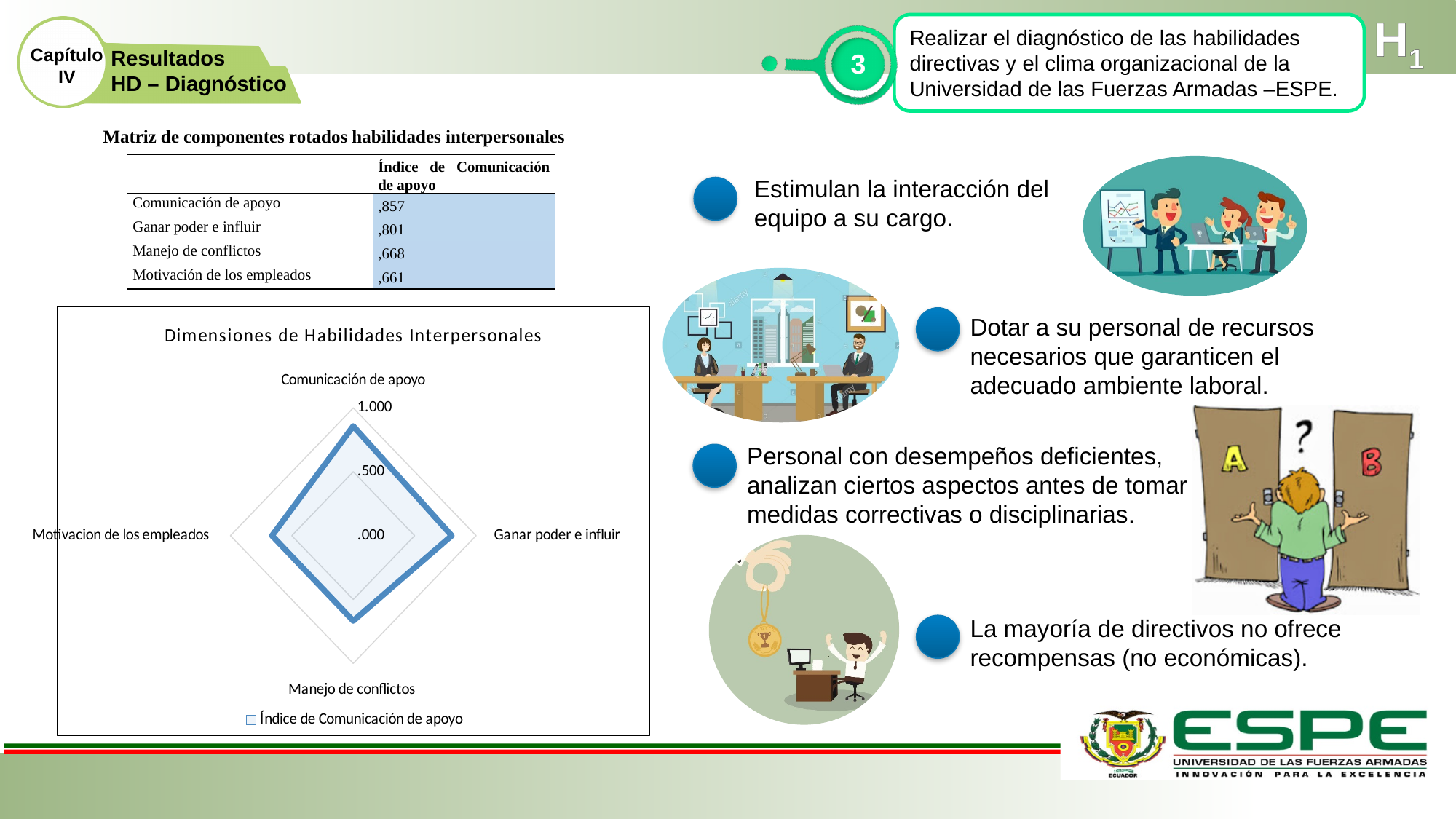
In the radar chart, is the value for Motivacion de los empleados greater or less than .500? greater In the radar chart, which has the larger value: Comunicación de apoyo or Manejo de conflictos? Comunicación de apoyo What is the name of the series shown in the legend of the radar chart? Índice de Comunicación de apoyo In the radar chart, is the value for Ganar poder e influir greater or less than 1.000? less In the radar chart, is the value for Comunicación de apoyo greater or less than .500? greater What is the title of the radar chart on the slide? Dimensiones de Habilidades Interpersonales In the radar chart, which has the larger value: Ganar poder e influir or Motivacion de los empleados? Ganar poder e influir What kind of chart is "Dimensiones de Habilidades Interpersonales"? Radar chart How many series does the legend of the radar chart list? 1 How many categories are plotted on the radar chart "Dimensiones de Habilidades Interpersonales"? 4